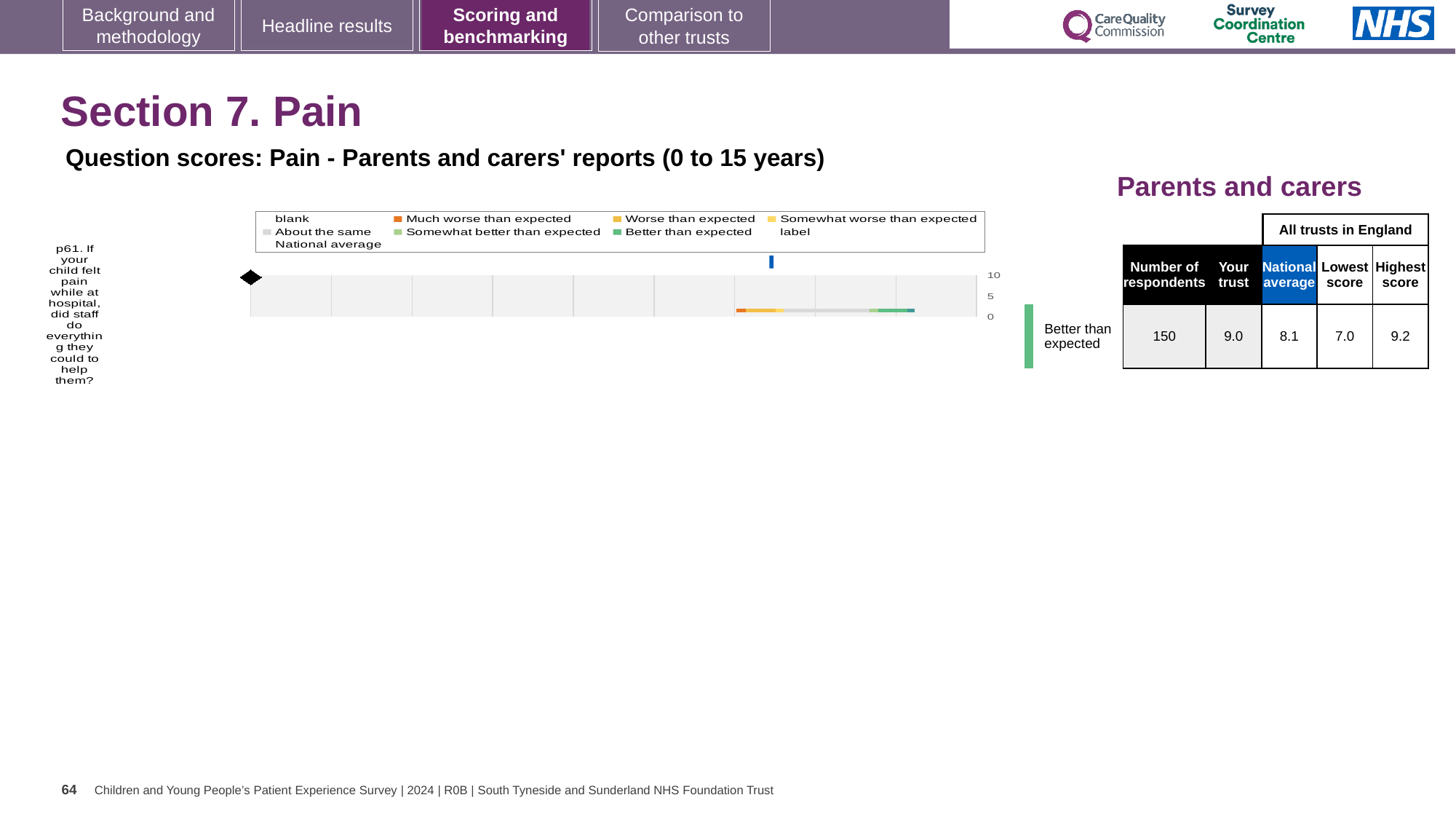
What is the National average score for question p61 in the Parents and carers table? 8.1 How many survey questions are plotted on the chart? 1 What is the Highest score among all trusts in England for question p61? 9.2 How many respondents answered question p61 in the Parents and carers table? 150 What is the highest value shown on the chart's axis? 10 Which colour does the legend use for 'Better than expected'? green For question p61, which is larger: the 'Your trust' score or the National average? Your trust What is the Lowest score among all trusts in England for question p61? 7.0 What is the difference between the 'Your trust' score and the National average for question p61? 0.9 What is the difference between the Highest score and the Lowest score for question p61? 2.2 What is the 'Your trust' score for question p61 in the Parents and carers table? 9.0 What kind of chart is used to show the score for question p61? bar chart